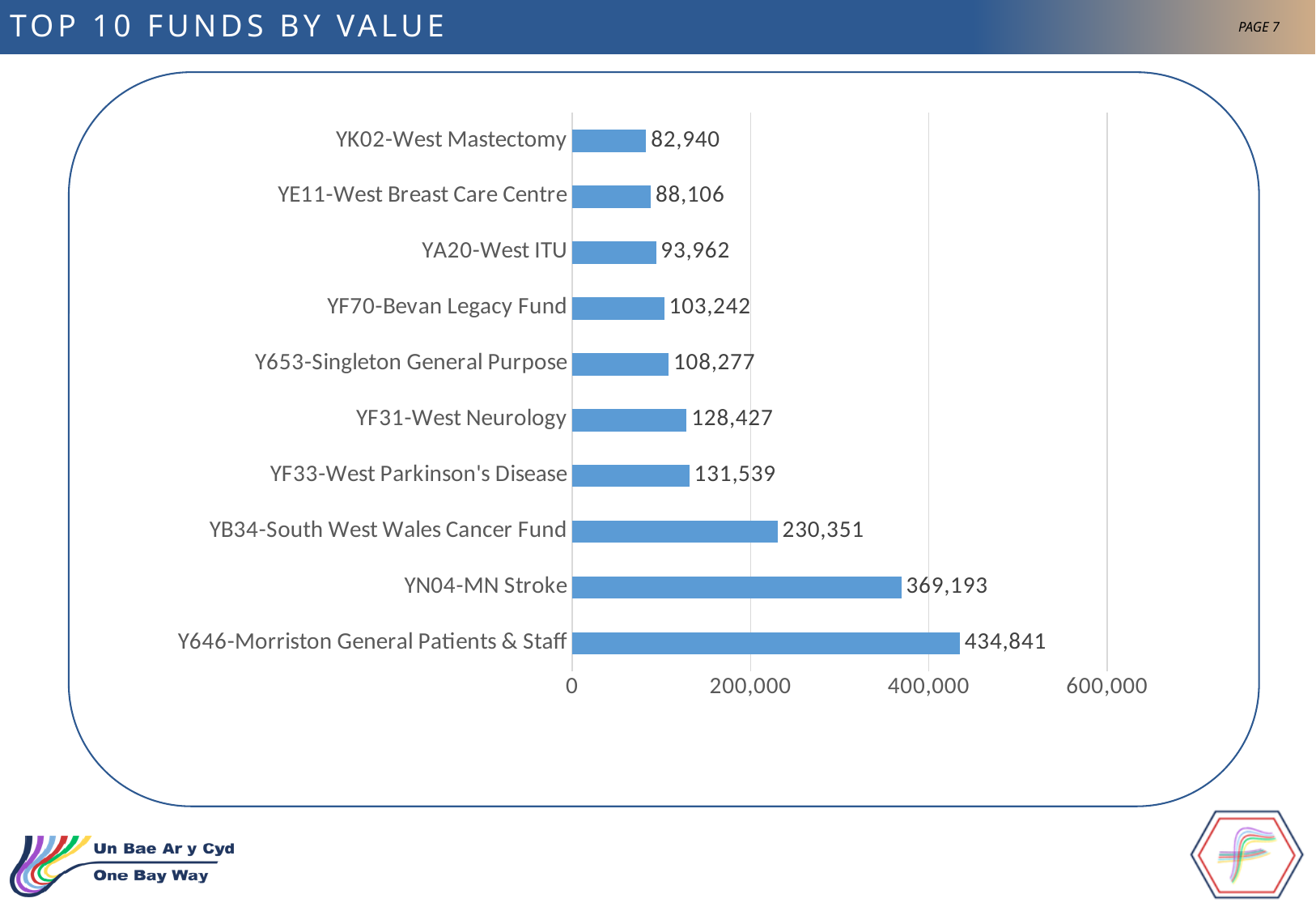
Is the value for YB34-South West Wales Cancer Fund greater or less than 200,000? greater What is the difference between the values for Y646-Morriston General Patients & Staff and YN04-MN Stroke? 65,648 What is the title of the slide? TOP 10 FUNDS BY VALUE What is the value for YB34-South West Wales Cancer Fund? 230,351 What is the value for YN04-MN Stroke? 369,193 How many funds are shown in the chart? 10 Which is larger, the value for YA20-West ITU or the value for Y653-Singleton General Purpose? Y653-Singleton General Purpose Which fund has the highest value? Y646-Morriston General Patients & Staff Which fund has the lowest value? YK02-West Mastectomy What is the value for YF70-Bevan Legacy Fund? 103,242 What kind of chart is shown on the slide? bar chart What is the difference between the values for YF33-West Parkinson's Disease and YF31-West Neurology? 3,112